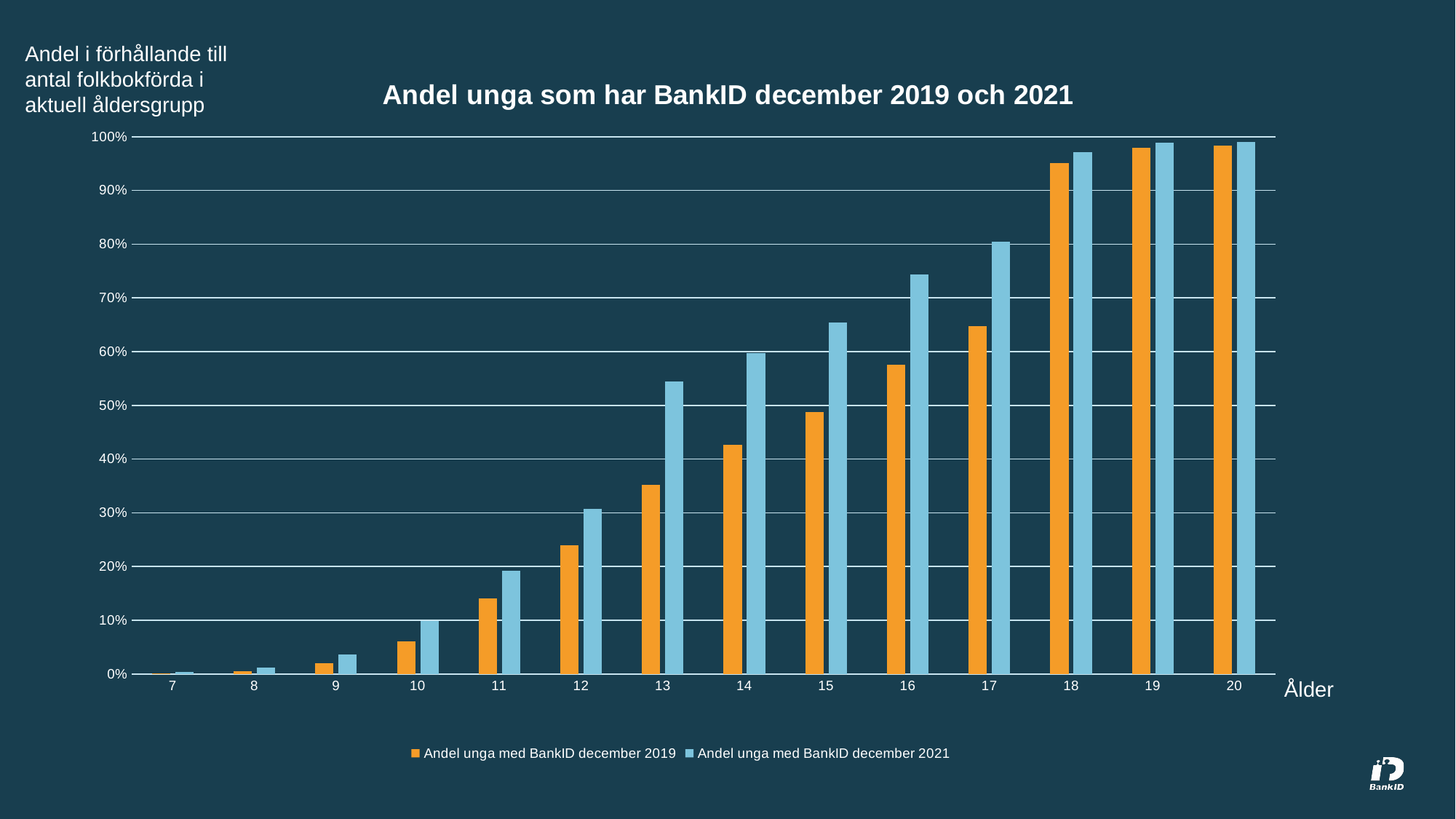
Is the value for age 16 in the 'Andel unga med BankID december 2021' series greater or less than 70%? greater Which age has the lowest value in the 'Andel unga med BankID december 2019' series? 7 What kind of chart is shown on the slide? Bar chart How many age categories are shown on the x axis? 14 Is the value for age 17 in the 'Andel unga med BankID december 2019' series greater or less than 60%? greater Is the value for age 12 in the 'Andel unga med BankID december 2019' series greater or less than 30%? less For age 13, which series has the larger value: december 2019 or december 2021? december 2021 What is the title of the chart? Andel unga som har BankID december 2019 och 2021 How many series does the legend list? 2 Do the values rise or fall as age increases along the x axis? rise